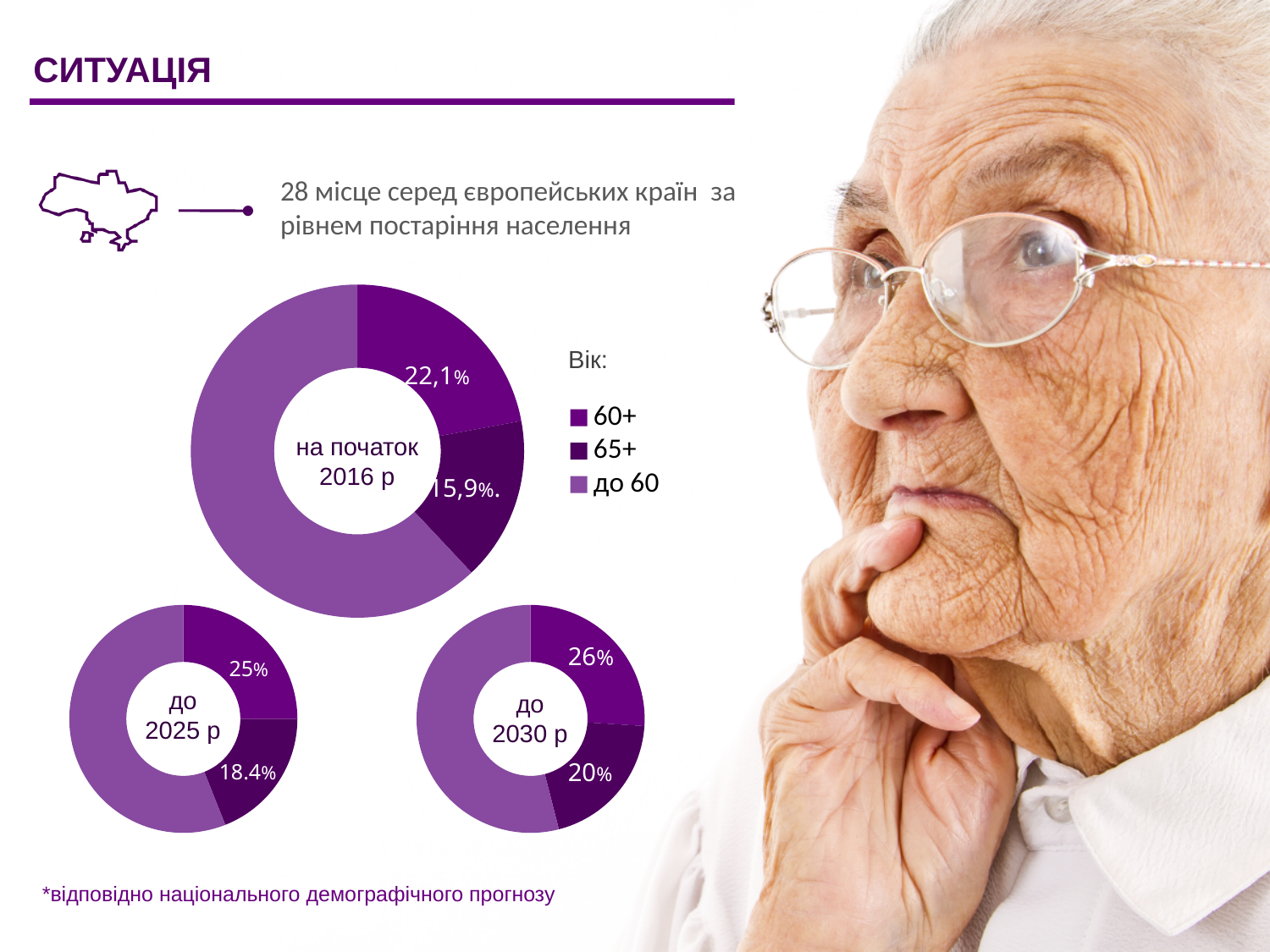
Does the share of the 60+ age group rise or fall from the 2016 chart to the 2030 chart? rise In the chart labelled "до 2030 р", what is the value for the 65+ age group? 20% In the chart labelled "на початок 2016 р", what is the value for the 60+ age group? 22,1% What kind of chart is used to show the age structure on this slide? pie (donut) chart In the chart labelled "до 2025 р", what is the value for the 65+ age group? 18.4% In the chart labelled "на початок 2016 р", what is the value for the 65+ age group? 15,9% In the chart labelled "на початок 2016 р", which age group takes the largest slice? до 60 In the chart labelled "до 2030 р", what is the value for the 60+ age group? 26% In the chart labelled "до 2030 р", which is larger, the 60+ slice or the 65+ slice? 60+ In the chart labelled "до 2025 р", what is the value for the 60+ age group? 25% In the chart labelled "на початок 2016 р", what is the difference between the 60+ value and the 65+ value? 6,2% How many age groups does the legend list? 3